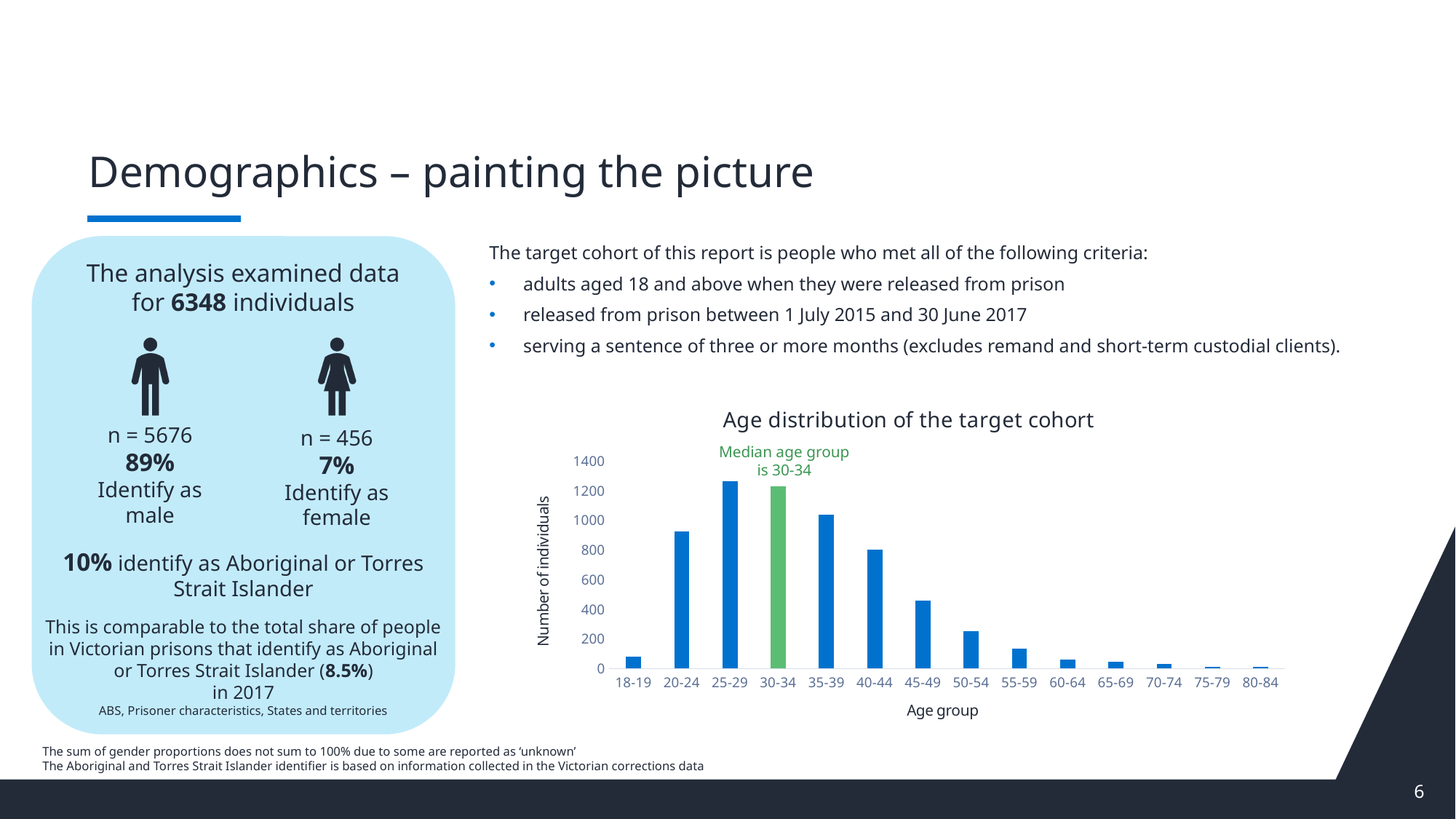
Is the value for the 45-49 age group greater or less than 600? less Is the value for the 35-39 age group greater or less than 1000? greater Is the value for the 25-29 age group greater or less than 1200? greater Which age group has more individuals, 40-44 or 45-49? 40-44 Which age group is labelled as the median age group on the chart? 30-34 How many age groups are shown on the x axis of the age distribution chart? 14 What kind of chart is 'Age distribution of the target cohort'? bar chart What is the y-axis title of the age distribution chart? Number of individuals From the 30-34 age group onwards, do the values rise or fall as age increases? fall Which age group has more individuals, 35-39 or 20-24? 35-39